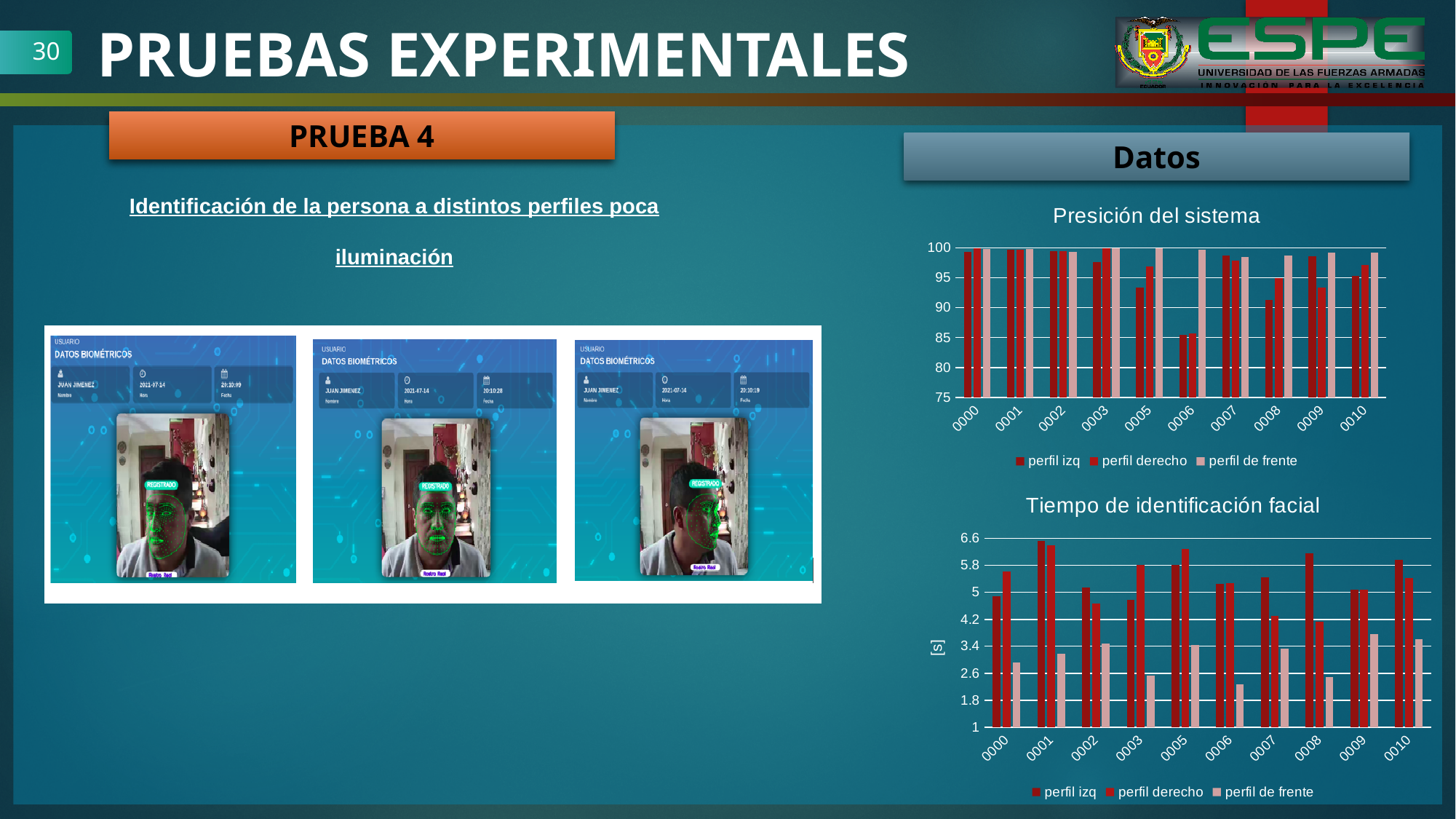
In the 'Presición del sistema' chart, is the value of 'perfil izq' for 0005 greater or less than 90? greater In the 'Tiempo de identificación facial' chart, is the value of 'perfil de frente' for 0006 greater or less than 2.6? less In the 'Tiempo de identificación facial' chart, is the value of 'perfil izq' for 0001 greater or less than 5.8? greater How many categories are shown on the x axis of the 'Tiempo de identificación facial' chart? 10 In the 'Presición del sistema' chart, which category has the lowest 'perfil izq' value? 0006 How many series does the legend of the 'Presición del sistema' chart list? 3 In the 'Tiempo de identificación facial' chart, which is larger, the 'perfil izq' value for 0000 or for 0001? 0001 In the 'Presición del sistema' chart, which is larger, the 'perfil izq' value for 0000 or for 0006? 0000 What type of chart is the 'Presición del sistema' chart? bar chart What is the y-axis label of the 'Tiempo de identificación facial' chart? [s]